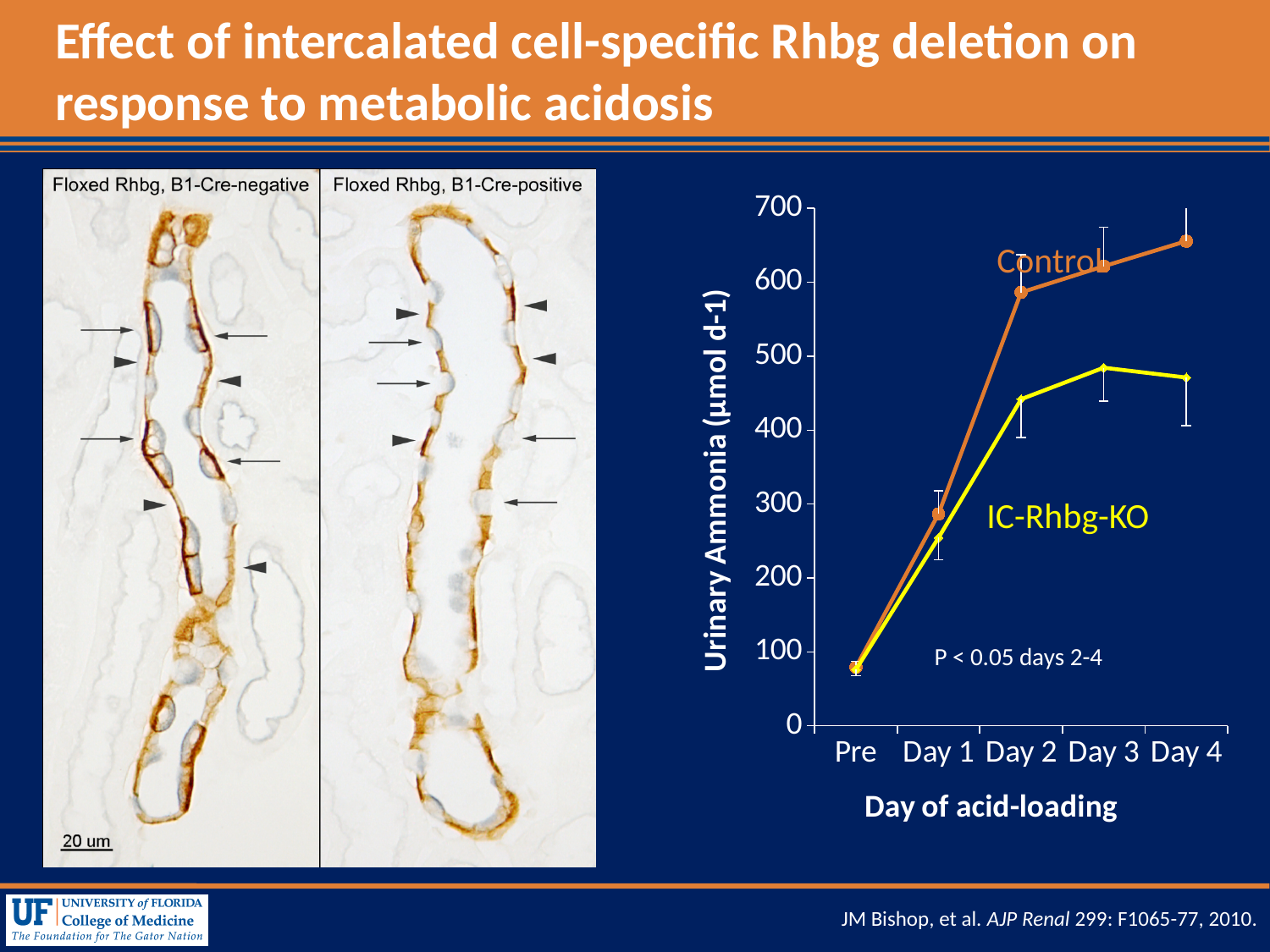
What kind of chart is shown on the right side of the slide? line chart How many series are plotted in the chart? 2 Is the Control value at Day 4 greater or less than 600? greater Does the Control series rise or fall from Pre to Day 4? rise What is the y-axis title of the chart? Urinary Ammonia (µmol d-1) Is the Control value at Day 2 greater or less than 500? greater Is the IC-Rhbg-KO value at Pre greater or less than 100? less At which day of acid-loading does the Control series reach its highest value? Day 4 At Day 4, which series has the higher urinary ammonia value, Control or IC-Rhbg-KO? Control How many time points are shown on the x axis of the chart? 5 At which x-axis point is the IC-Rhbg-KO series lowest? Pre